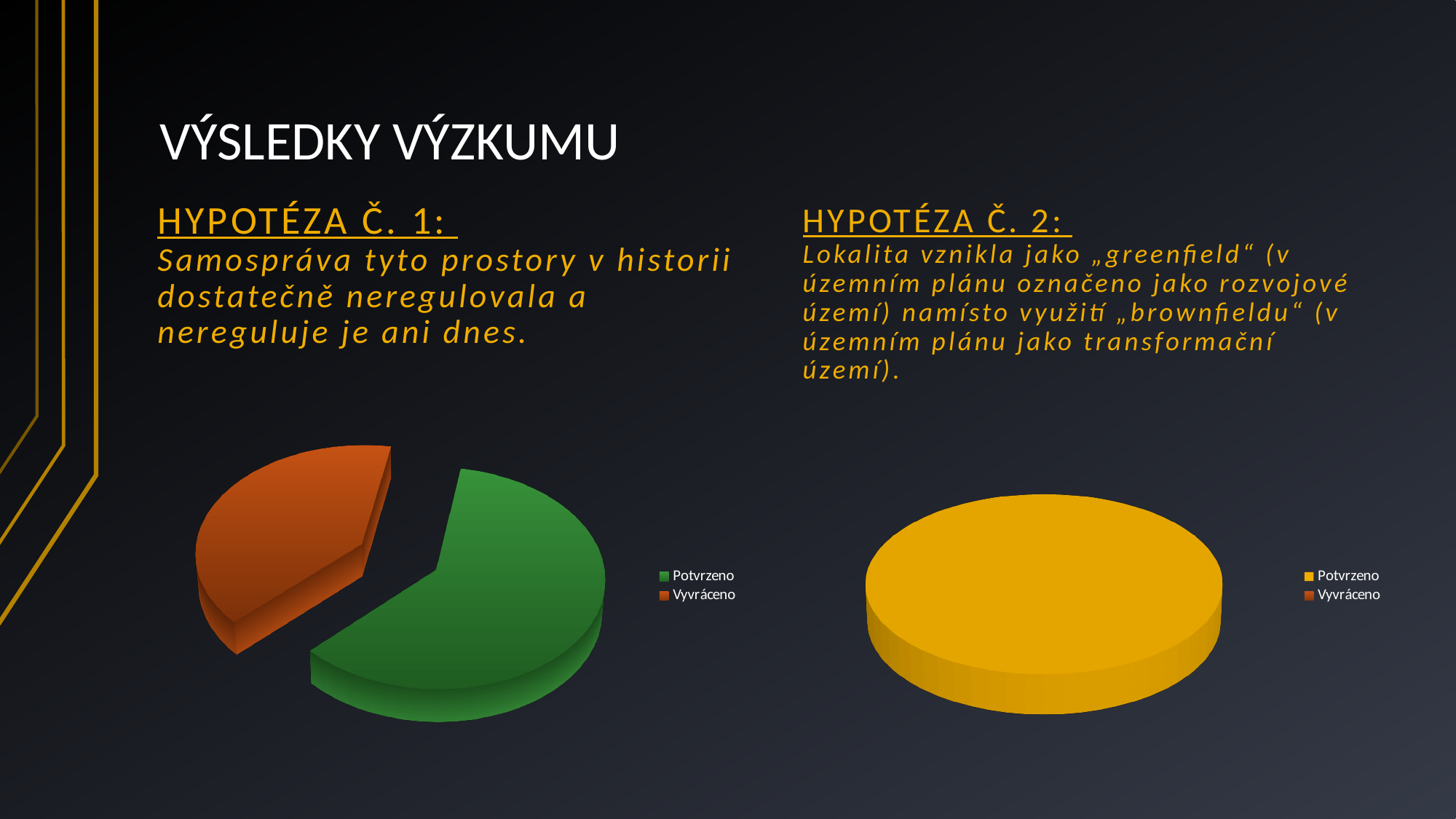
In the left pie chart (Hypotéza č. 1), which slice is larger, Potvrzeno or Vyvráceno? Potvrzeno In the right pie chart (Hypotéza č. 2), which category takes up the whole pie? Potvrzeno What kind of chart is shown under Hypotéza č. 2 on the right? pie chart In the right pie chart (Hypotéza č. 2), which slice is larger, Potvrzeno or Vyvráceno? Potvrzeno In the right pie chart (Hypotéza č. 2), how many entries does the legend list? 2 What kind of chart is shown under Hypotéza č. 1 on the left? pie chart In the left pie chart (Hypotéza č. 1), which category has the largest slice? Potvrzeno In the left pie chart (Hypotéza č. 1), how many entries does the legend list? 2 In the left pie chart (Hypotéza č. 1), which category has the smallest slice? Vyvráceno In the right pie chart (Hypotéza č. 2), what colour represents Potvrzeno? yellow In the left pie chart (Hypotéza č. 1), what colour represents Vyvráceno? orange